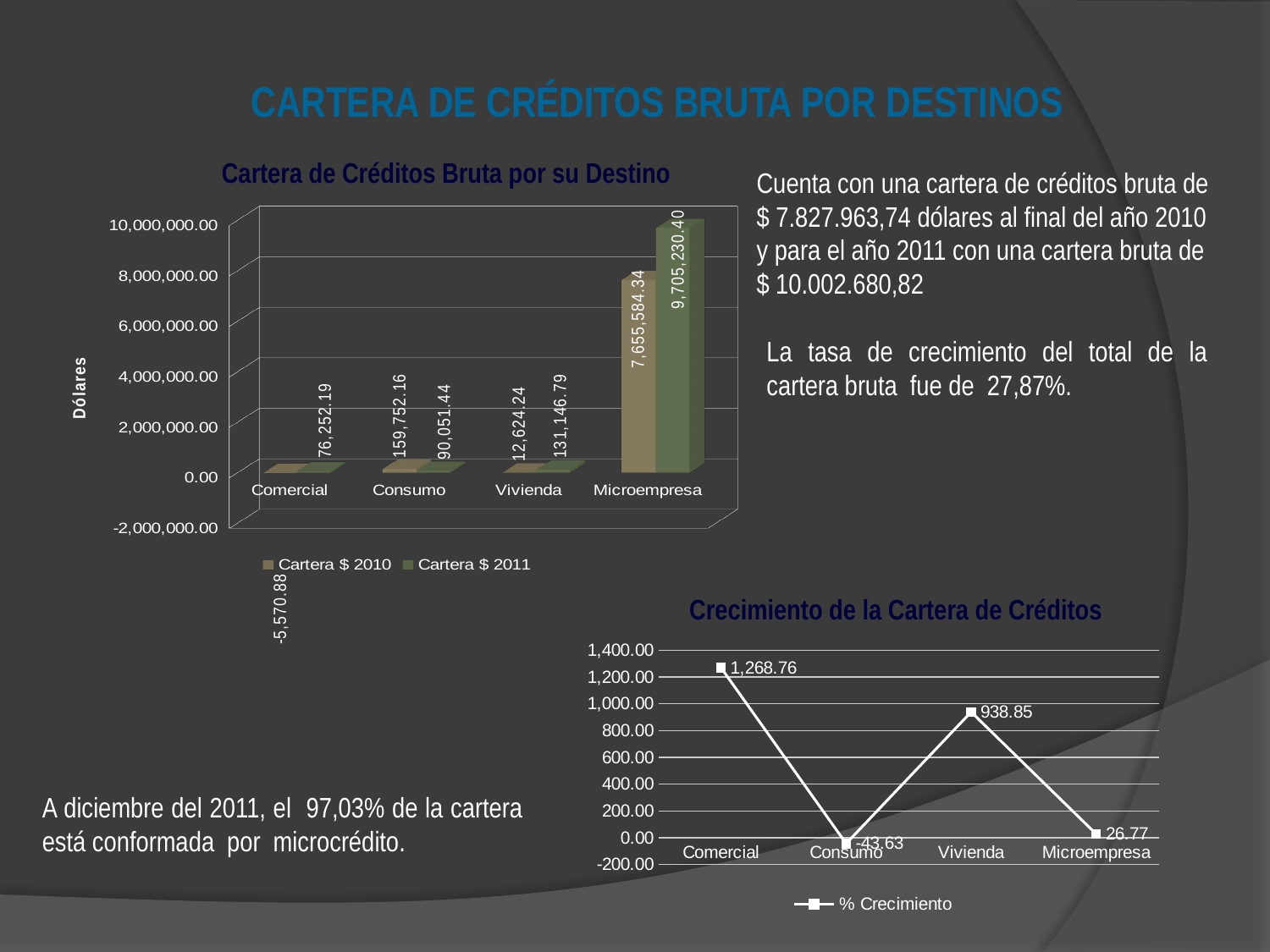
In the chart 'Cartera de Créditos Bruta por su Destino', what is the Cartera $ 2011 value for Vivienda? 131,146.79 In the chart 'Cartera de Créditos Bruta por su Destino', how many series does the legend list? 2 In the chart 'Cartera de Créditos Bruta por su Destino', how many categories are shown on the x axis? 4 In the chart 'Crecimiento de la Cartera de Créditos', which category has the lowest % Crecimiento value? Consumo In the chart 'Crecimiento de la Cartera de Créditos', what is the % Crecimiento value for Comercial? 1,268.76 In the chart 'Cartera de Créditos Bruta por su Destino', which is larger for Consumo: Cartera $ 2010 or Cartera $ 2011? Cartera $ 2010 In the chart 'Cartera de Créditos Bruta por su Destino', which category has the highest Cartera $ 2011 value? Microempresa What kind of chart is 'Crecimiento de la Cartera de Créditos'? Line chart In the chart 'Cartera de Créditos Bruta por su Destino', what is the Cartera $ 2011 value for Microempresa? 9,705,230.40 In the chart 'Crecimiento de la Cartera de Créditos', what is the % Crecimiento value for Consumo? -43.63 In the chart 'Cartera de Créditos Bruta por su Destino', what is the Cartera $ 2010 value for Consumo? 159,752.16 What kind of chart is 'Cartera de Créditos Bruta por su Destino'? Bar chart